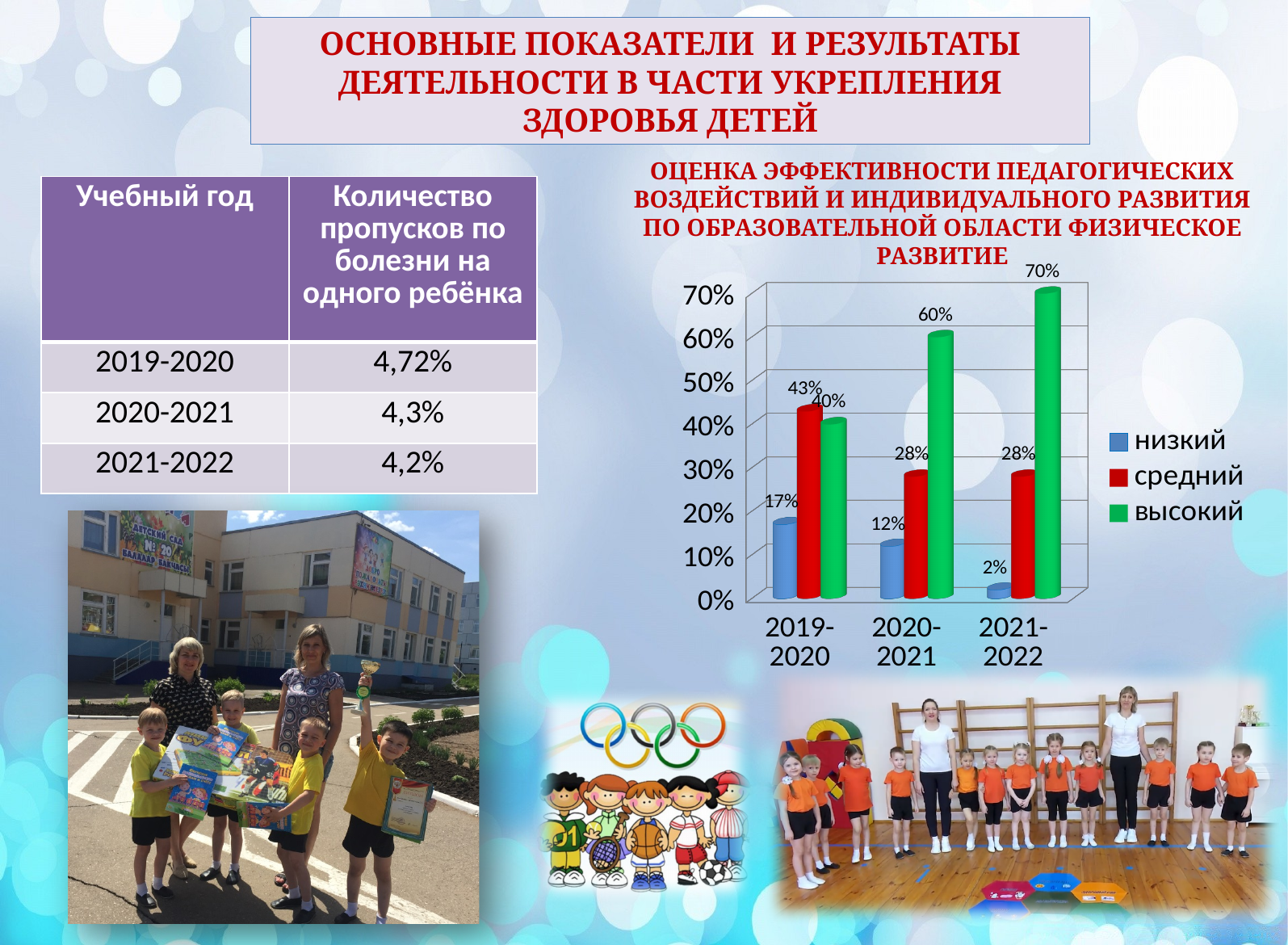
What is the value for высокий in 2021-2022? 70% How many years are shown on the x axis? 3 What is the difference between the высокий values for 2021-2022 and 2019-2020? 30% Which is larger in 2019-2020: средний or высокий? средний What kind of chart is shown on the slide? bar chart In which year is the value for низкий the lowest? 2021-2022 What is the value for средний in 2020-2021? 28% In which year is the value for высокий the highest? 2021-2022 What is the value for низкий in 2019-2020? 17% How many series does the legend list? 3 Does the value for низкий rise or fall from 2019-2020 to 2021-2022? fall What is the value for высокий in 2019-2020? 40%